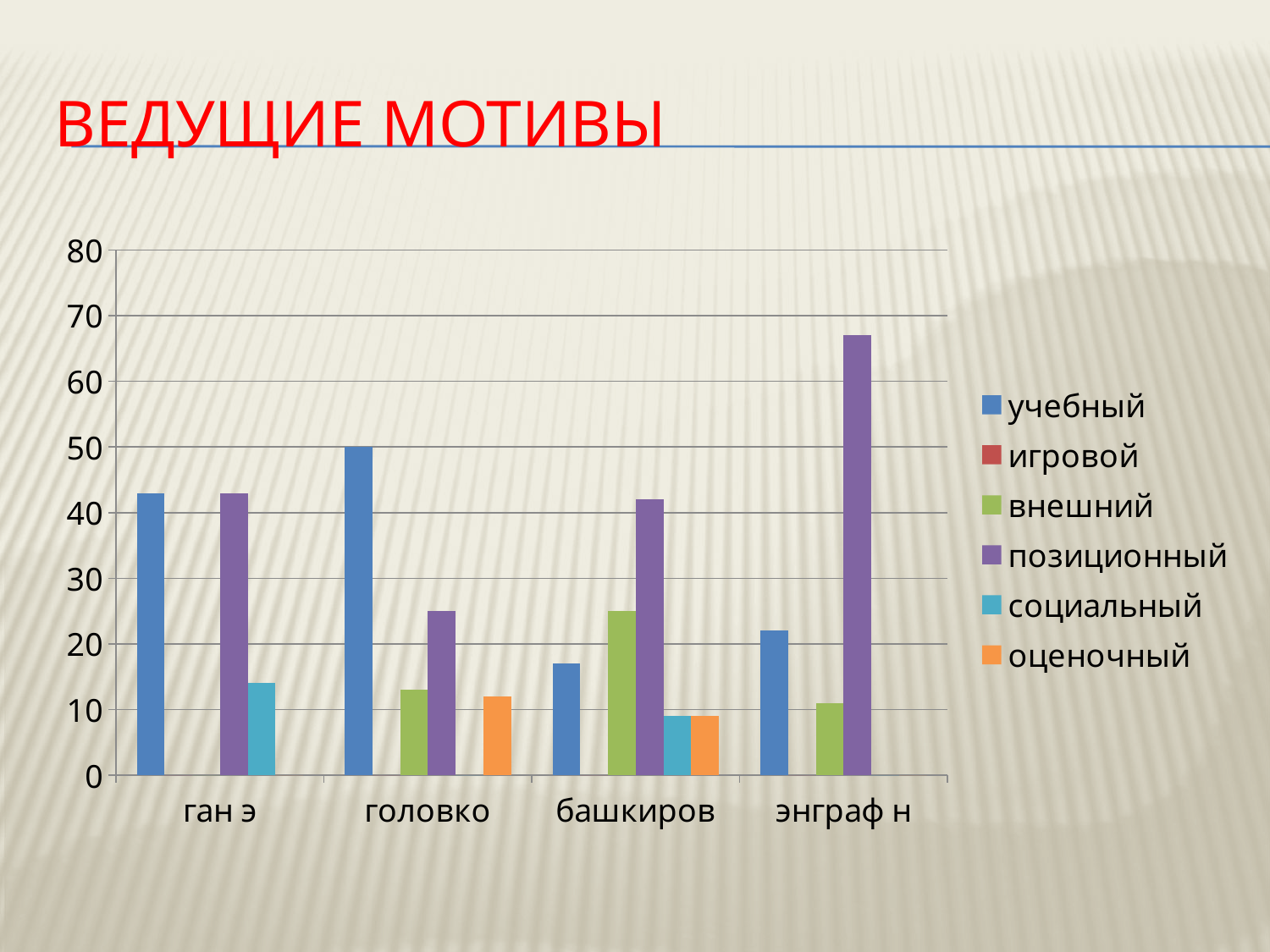
Which is larger for башкиров: внешний or учебный? внешний Which series is shown in orange in the legend? оценочный What is the title of the chart slide? ВЕДУЩИЕ МОТИВЫ Is the value of учебный for башкиров greater or less than 20? less What kind of chart is shown on the slide? bar chart Which series has the highest value for энграф н? позиционный Is the value of позиционный for энграф н greater or less than 60? greater Which is larger for головко: учебный or позиционный? учебный How many series does the chart legend list? 6 Which category has the tallest bar in the chart? энграф н Is the value of позиционный for башкиров greater or less than 40? greater How many categories are shown along the x axis of the chart? 4